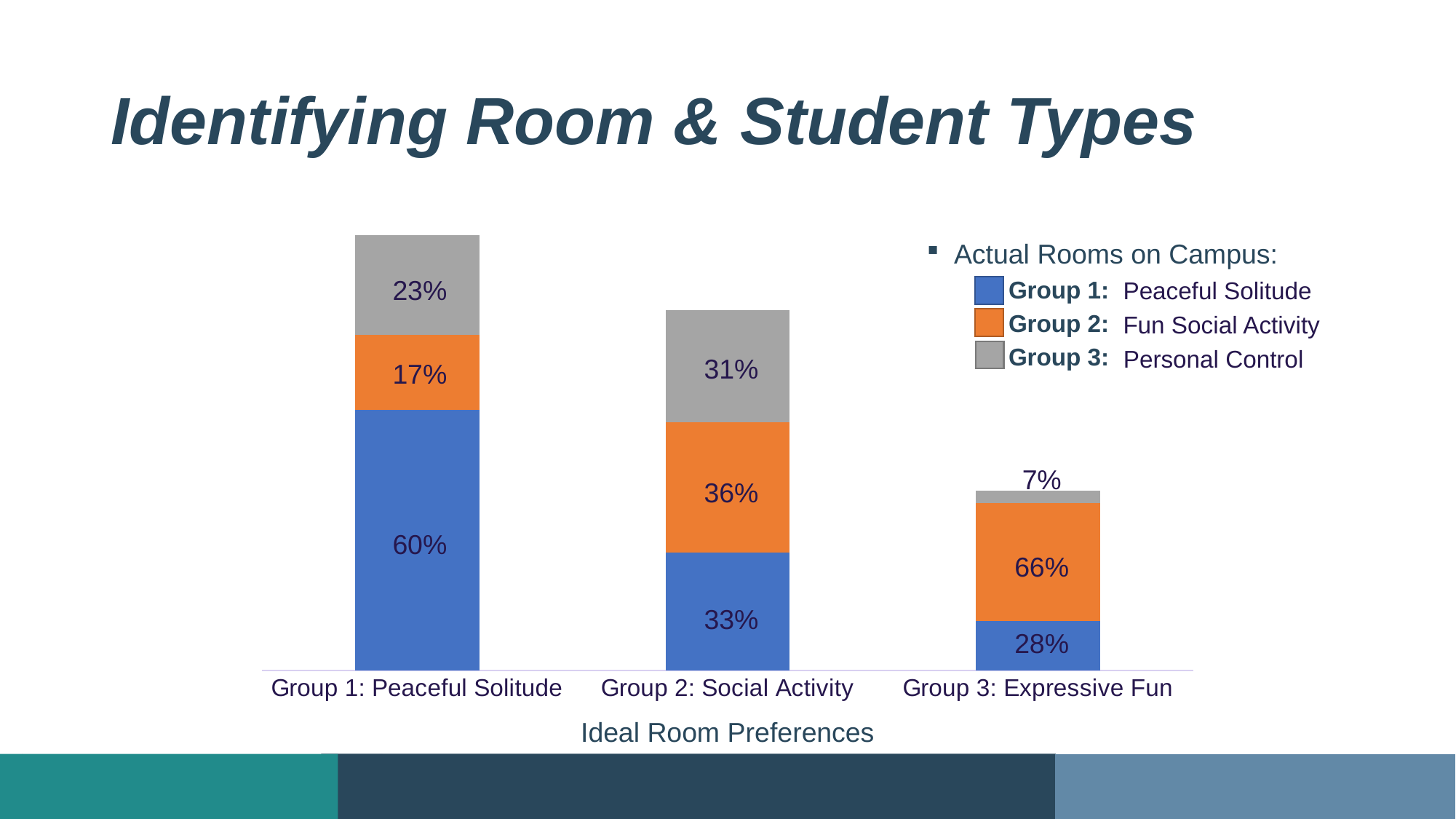
Which ideal room preference group has the lowest Group 3: Personal Control (grey) value? Group 3: Expressive Fun What kind of chart is shown on the slide? Stacked bar chart What is the Group 1: Peaceful Solitude (blue) value for the Group 1: Peaceful Solitude bar? 60% Which is larger: the orange segment of the Group 2: Social Activity bar or the grey segment of the Group 2: Social Activity bar? The orange segment (36%) What is the Group 3: Personal Control (grey) value for the Group 3: Expressive Fun bar? 7% Which ideal room preference group has the highest Group 1: Peaceful Solitude (blue) value? Group 1: Peaceful Solitude How many series does the legend list? 3 What is the Group 3: Personal Control (grey) value for the Group 2: Social Activity bar? 31% What is the x-axis title of the chart? Ideal Room Preferences What is the difference between the Group 2: Fun Social Activity (orange) values for the Group 3: Expressive Fun bar and the Group 1: Peaceful Solitude bar? 49% How many ideal room preference groups are shown on the x axis? 3 What is the Group 2: Fun Social Activity (orange) value for the Group 3: Expressive Fun bar? 66%